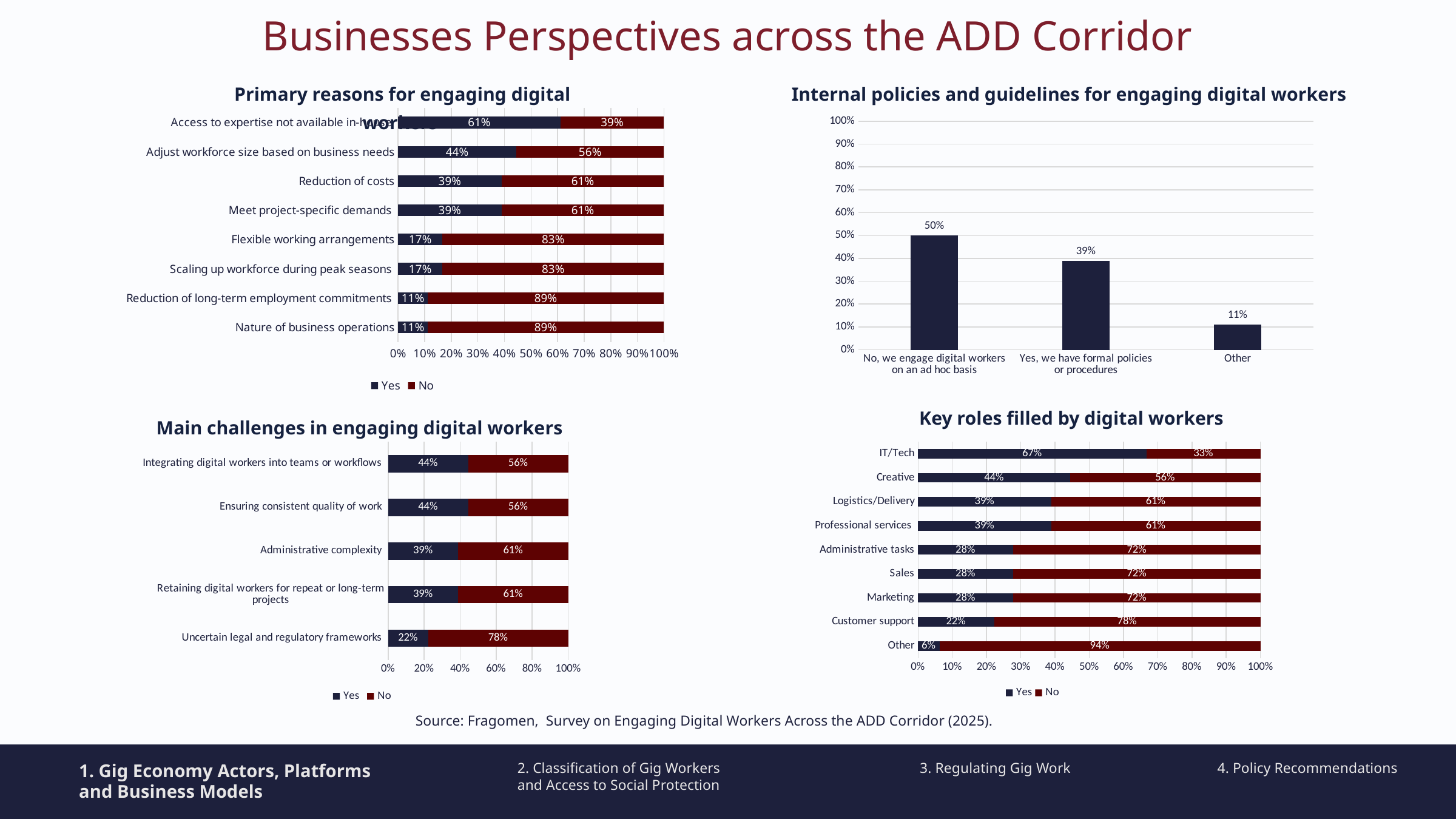
In the 'Internal policies and guidelines for engaging digital workers' chart, which category has the highest value? No, we engage digital workers on an ad hoc basis What kind of chart is 'Internal policies and guidelines for engaging digital workers'? Bar chart In the 'Primary reasons for engaging digital workers' chart, how many reasons are listed? 8 How many series does the legend of the 'Key roles filled by digital workers' chart list? 2 In the 'Key roles filled by digital workers' chart, which role has the highest Yes value? IT/Tech In the 'Internal policies and guidelines for engaging digital workers' chart, what is the value for 'Yes, we have formal policies or procedures'? 39% In the 'Internal policies and guidelines for engaging digital workers' chart, what is the difference between the 'No, we engage digital workers on an ad hoc basis' value and the 'Other' value? 39% In the 'Primary reasons for engaging digital workers' chart, what is the Yes value for 'Access to expertise not available in-house'? 61% In the 'Primary reasons for engaging digital workers' chart, what is the No value for 'Flexible working arrangements'? 83% In the 'Main challenges in engaging digital workers' chart, what is the Yes value for 'Uncertain legal and regulatory frameworks'? 22% In the 'Key roles filled by digital workers' chart, what is the No value for 'Customer support'? 78% In the 'Main challenges in engaging digital workers' chart, how many challenges are listed? 5